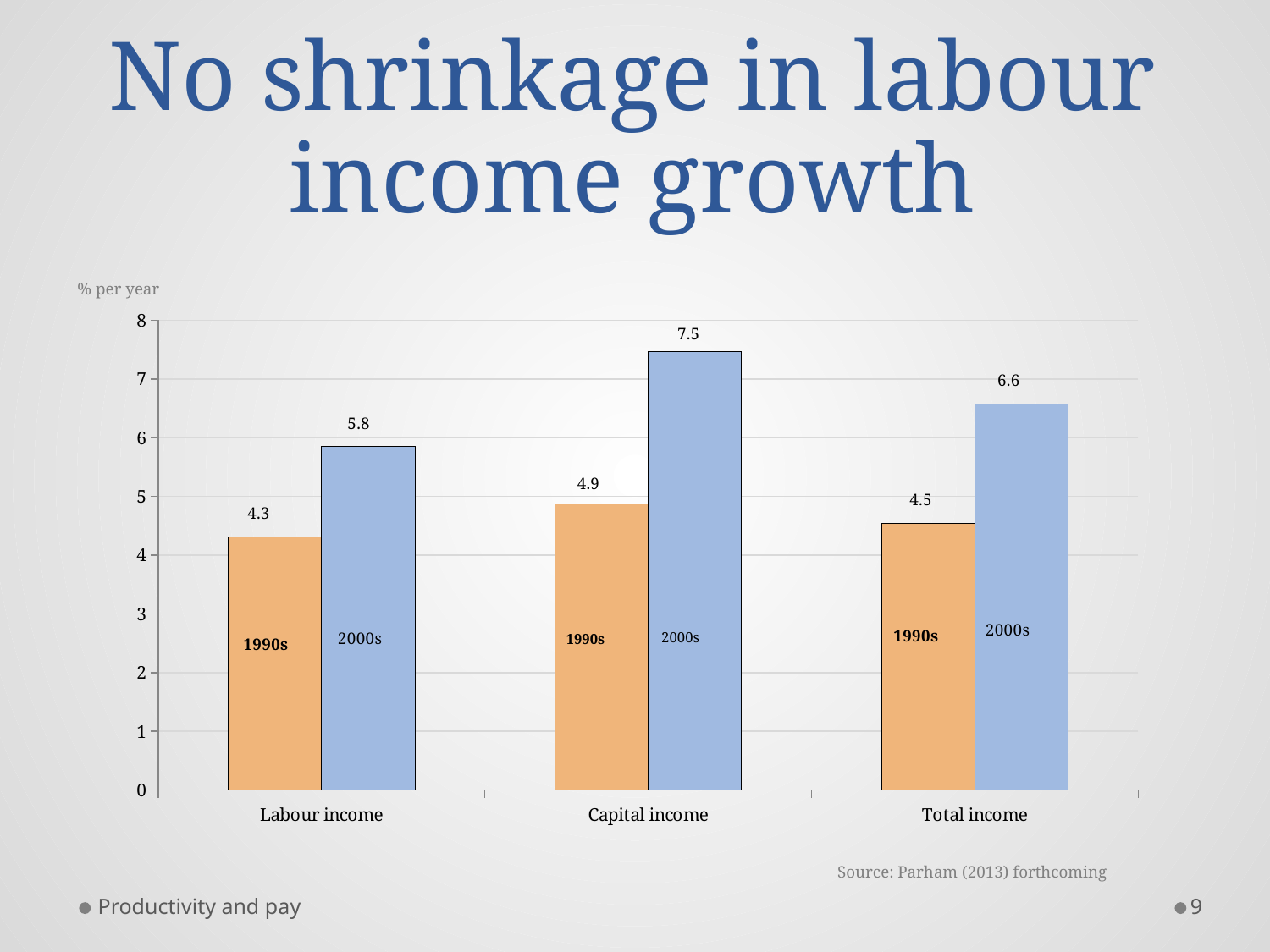
What unit is shown on the chart's axis label? % per year How many income categories are shown on the x axis? 3 What is the value for Labour income in the 1990s? 4.3 What is the value for Total income in the 1990s? 4.5 Which category has the highest value in the 2000s? Capital income What is the value for Capital income in the 2000s? 7.5 Which is larger, the 2000s value for Labour income or the 2000s value for Total income? Total income Which category has the lowest value in the 1990s? Labour income Is the value for Capital income in the 2000s greater or less than 7? greater What is the difference between the 2000s and 1990s values for Capital income? 2.6 What kind of chart is shown on the slide? Bar chart What is the difference between the 2000s and 1990s values for Labour income? 1.5